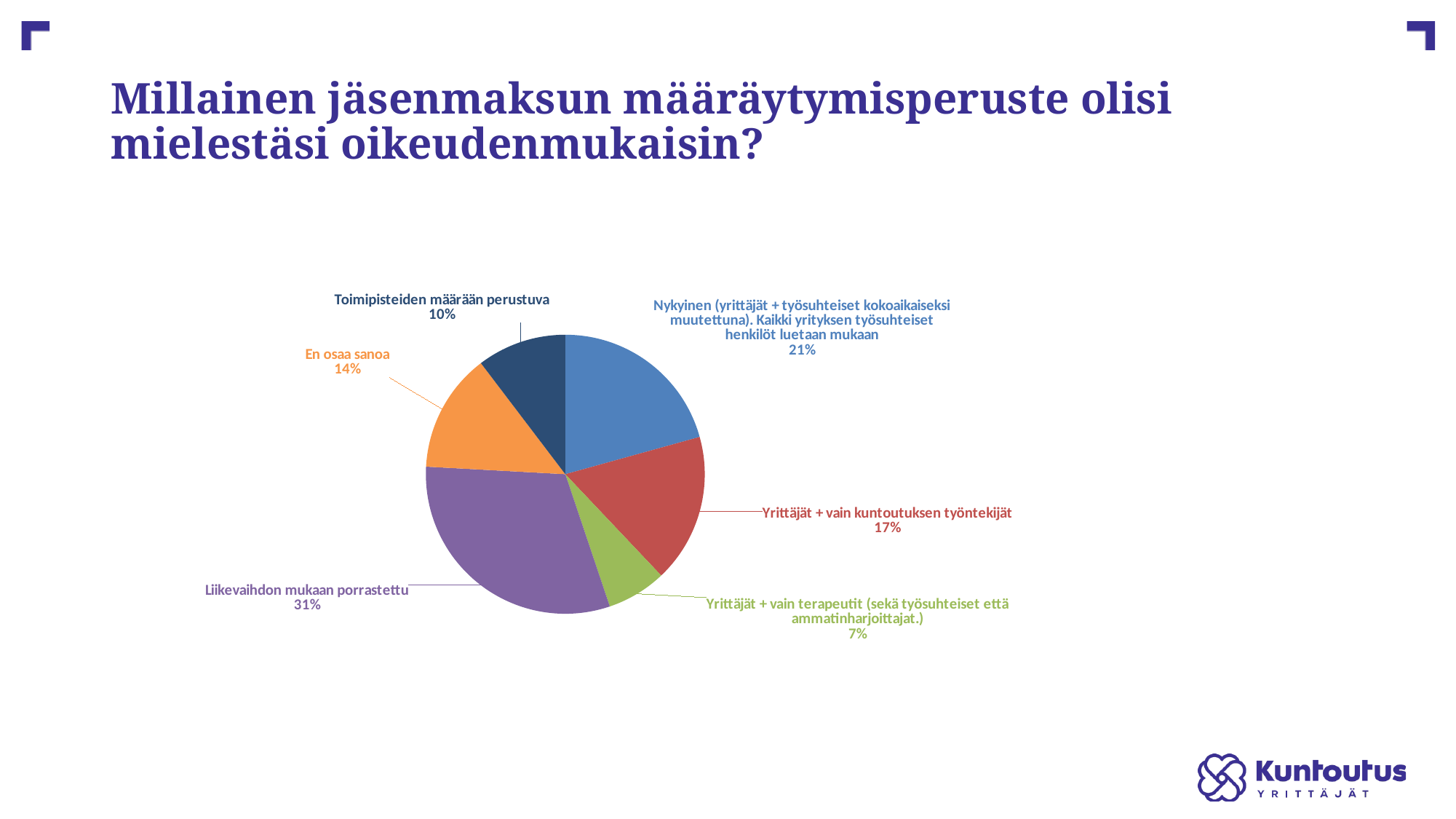
What kind of chart is shown on the slide? Pie chart Which is larger: the share for "Yrittäjät + vain kuntoutuksen työntekijät" or the share for "Toimipisteiden määrään perustuva"? Yrittäjät + vain kuntoutuksen työntekijät Which category has the largest share of the pie? Liikevaihdon mukaan porrastettu What share of the pie does "Liikevaihdon mukaan porrastettu" have? 31% What percentage is shown for "Yrittäjät + vain kuntoutuksen työntekijät"? 17% Which category has the smallest share of the pie? Yrittäjät + vain terapeutit (sekä työsuhteiset että ammatinharjoittajat.) What percentage is shown for "Yrittäjät + vain terapeutit (sekä työsuhteiset että ammatinharjoittajat.)"? 7% What is the difference in percentage points between "Liikevaihdon mukaan porrastettu" and "En osaa sanoa"? 17 How many slices does the pie chart have? 6 What percentage is shown for "En osaa sanoa"? 14% What percentage is shown for "Toimipisteiden määrään perustuva"? 10% What colour is the slice for "En osaa sanoa"? Orange